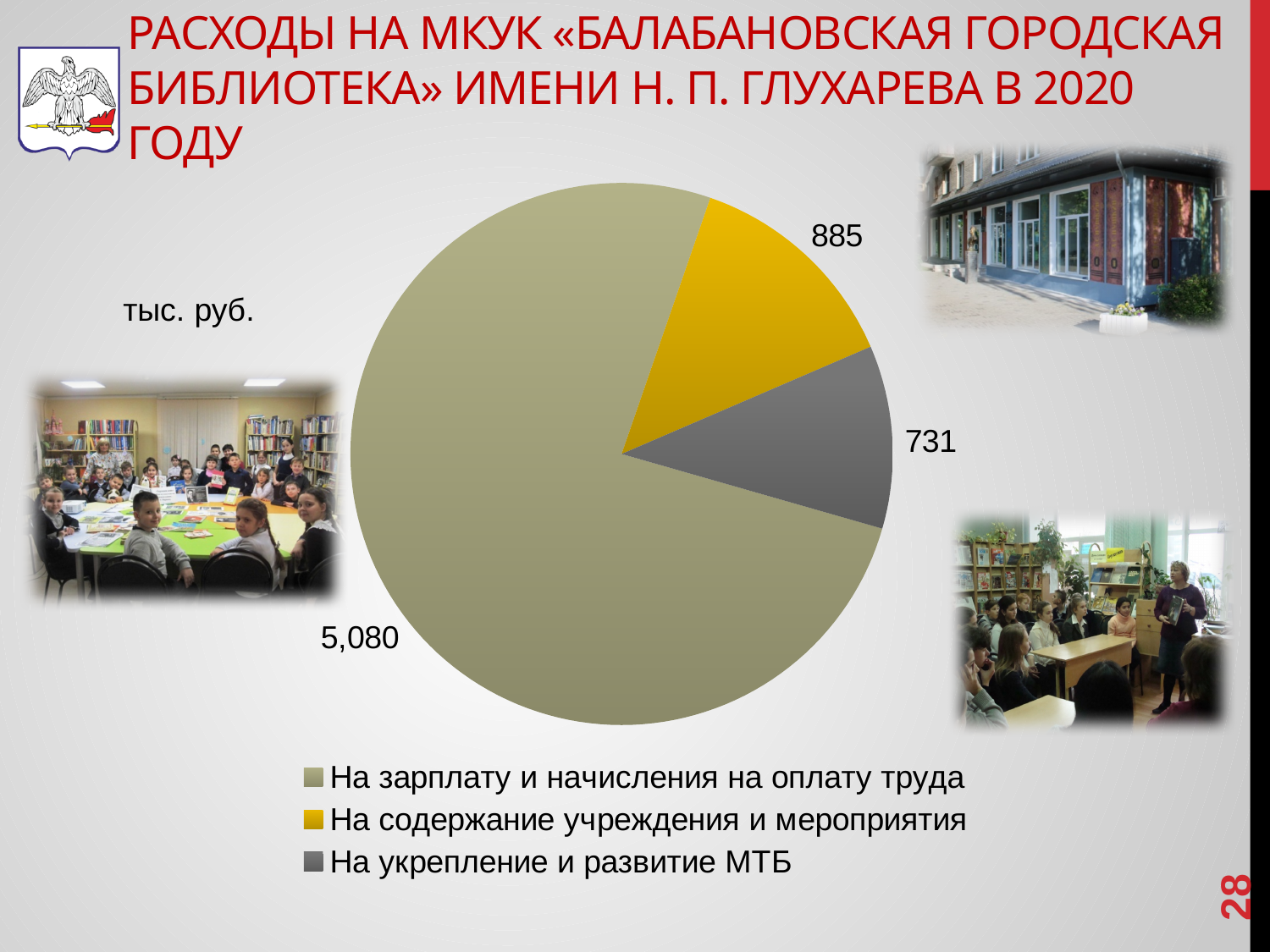
How many slices does the pie chart have? 3 What is the value for «На зарплату и начисления на оплату труда»? 5,080 Which is larger: the value for «На содержание учреждения и мероприятия» or for «На укрепление и развитие МТБ»? На содержание учреждения и мероприятия Which category has the largest slice? На зарплату и начисления на оплату труда What is the value for «На содержание учреждения и мероприятия»? 885 What is the difference between the values for «На содержание учреждения и мероприятия» and «На укрепление и развитие МТБ»? 154 What kind of chart is shown on the slide? pie chart Which category has the smallest slice? На укрепление и развитие МТБ What is the value for «На укрепление и развитие МТБ»? 731 How many entries does the legend list? 3 What unit is indicated for the values on the chart? тыс. руб. What is the total of all three slices? 6,696